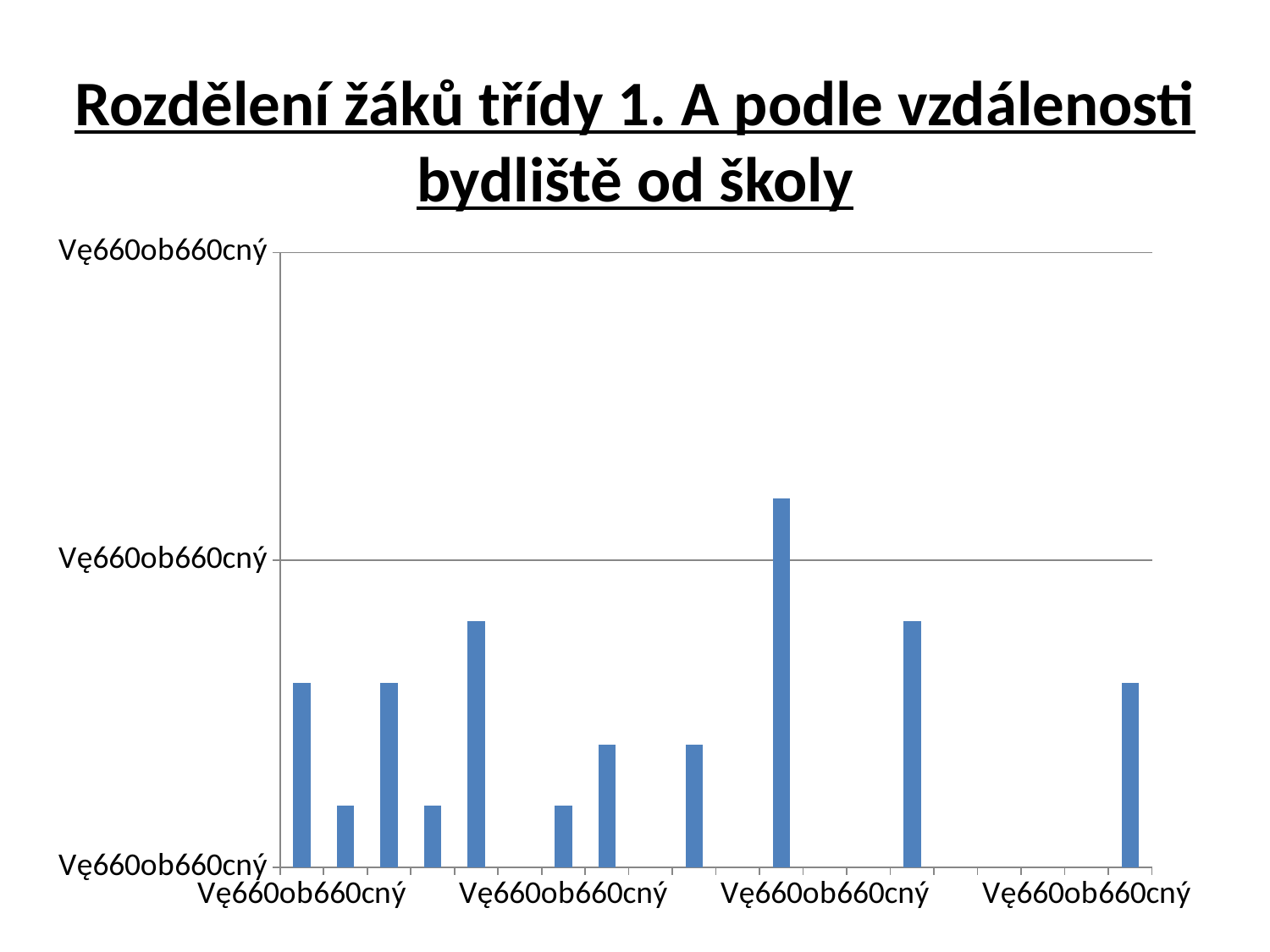
What colour are the bars in the chart? blue What kind of chart is shown on the slide? bar chart Is the ninth bar from the left taller or shorter than the tenth bar from the left? taller What is the title of the slide containing the chart? Rozdělení žáků třídy 1. A podle vzdálenosti bydliště od školy Counting from the left, which bar is the tallest in the chart? the ninth bar How many bars are plotted in the chart? 11 Is the second bar from the left taller or shorter than the first bar from the left? shorter